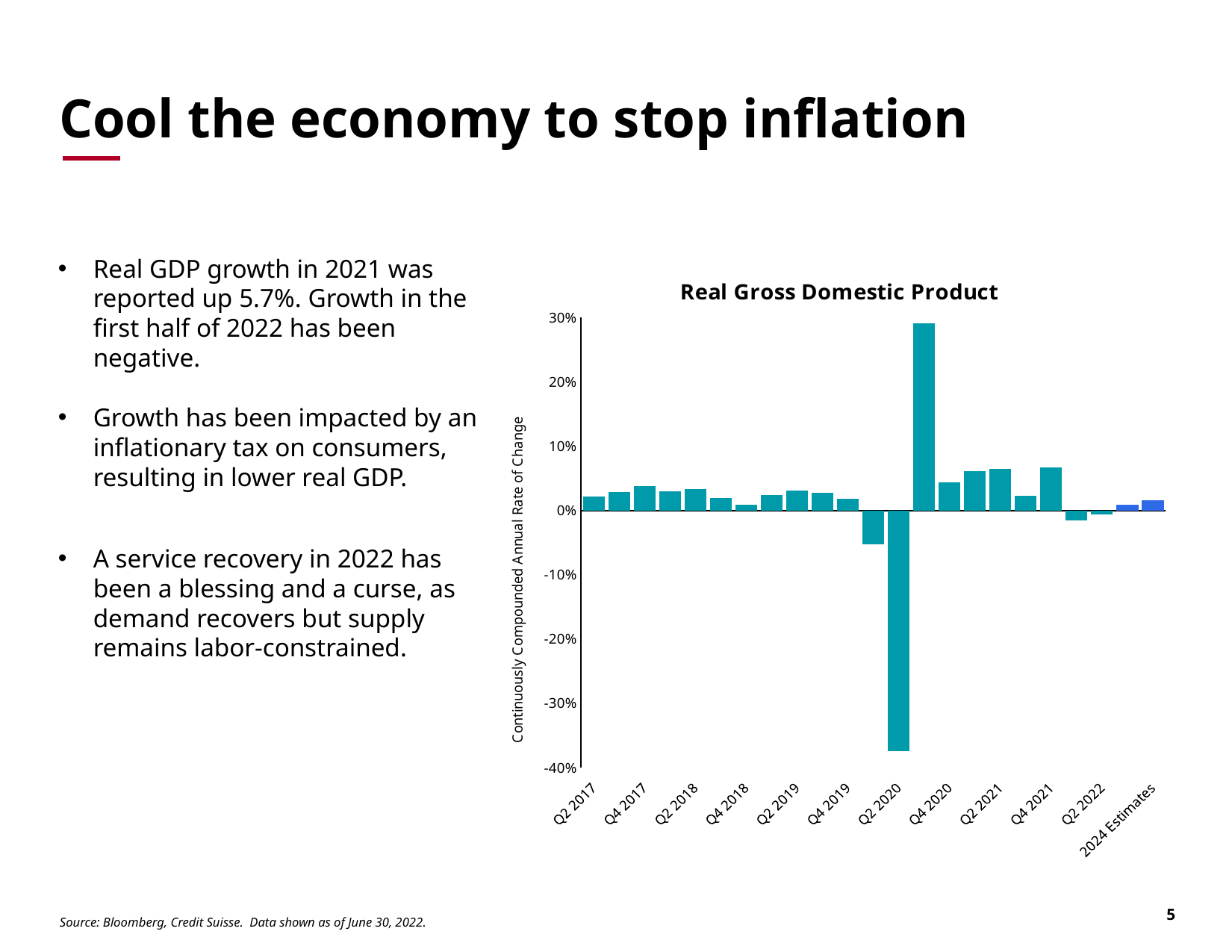
Is the value for 2024 Estimates greater or less than 0%? greater Is the value for Q2 2017 greater or less than 10%? less What kind of chart is shown on the slide? bar chart Is the value for Q4 2021 greater or less than 0%? greater Which labeled quarter has the lowest value in the chart? Q2 2020 Which is larger, the value for Q4 2021 or the value for Q2 2022? Q4 2021 Which is larger, the value for Q2 2020 or the value for Q4 2020? Q4 2020 What is the label on the vertical axis of the chart? Continuously Compounded Annual Rate of Change What is the title of the chart? Real Gross Domestic Product